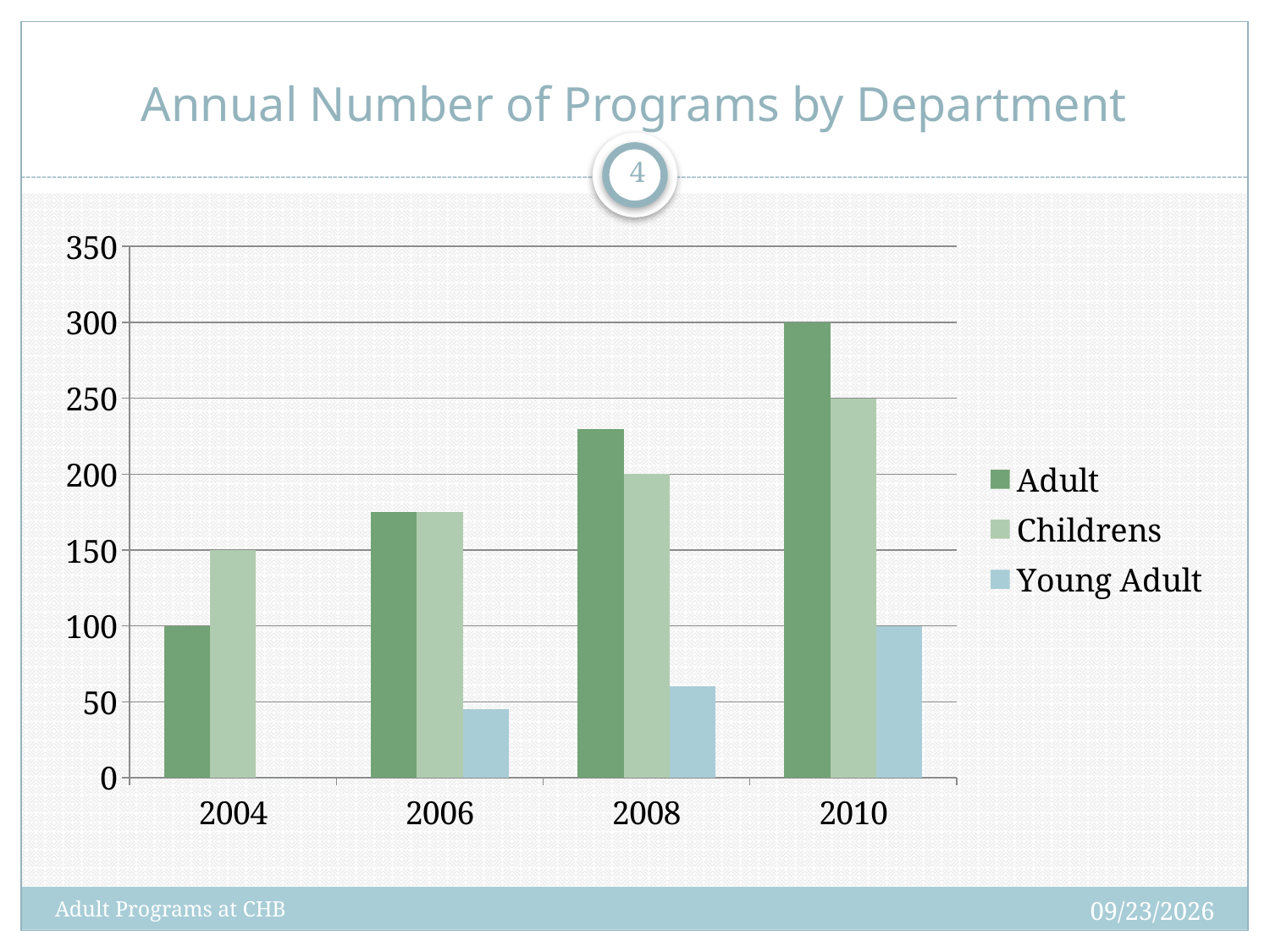
How many years are shown on the x axis? 4 What type of chart is shown on the slide? Bar chart What is the value for Childrens in 2010? 250 What is the difference between the Adult and Childrens values in 2010? 50 How many series does the legend list? 3 What is the value for Adult in 2004? 100 Is the value for Adult in 2008 greater or less than 200? greater What is the value for Adult in 2010? 300 Do the Adult values rise or fall from 2004 to 2010? Rise Which year has the highest Adult value? 2010 What is the value for Childrens in 2004? 150